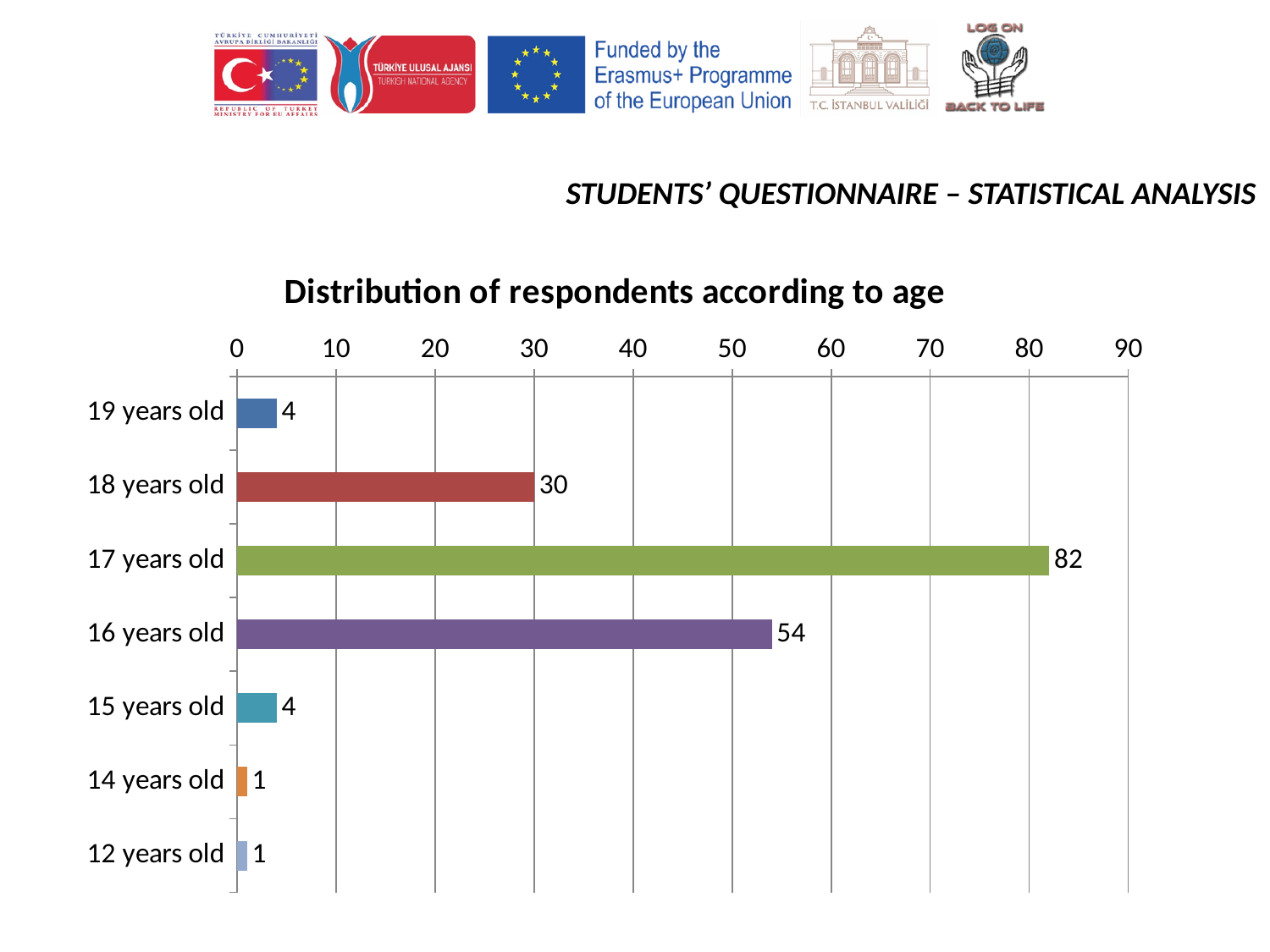
Which is larger, the value for 18 years old or the value for 16 years old? 16 years old What is the value for 17 years old? 82 What is the value for 14 years old? 1 What is the title of the chart? Distribution of respondents according to age What is the difference between the values for 18 years old and 15 years old? 26 Which age group has the highest number of respondents? 17 years old What is the value for 16 years old? 54 What is the value for 18 years old? 30 How many age categories are shown in the chart? 7 What is the difference between the values for 17 years old and 16 years old? 28 Is the value for 17 years old greater or less than 80? greater What kind of chart is shown on the slide? bar chart